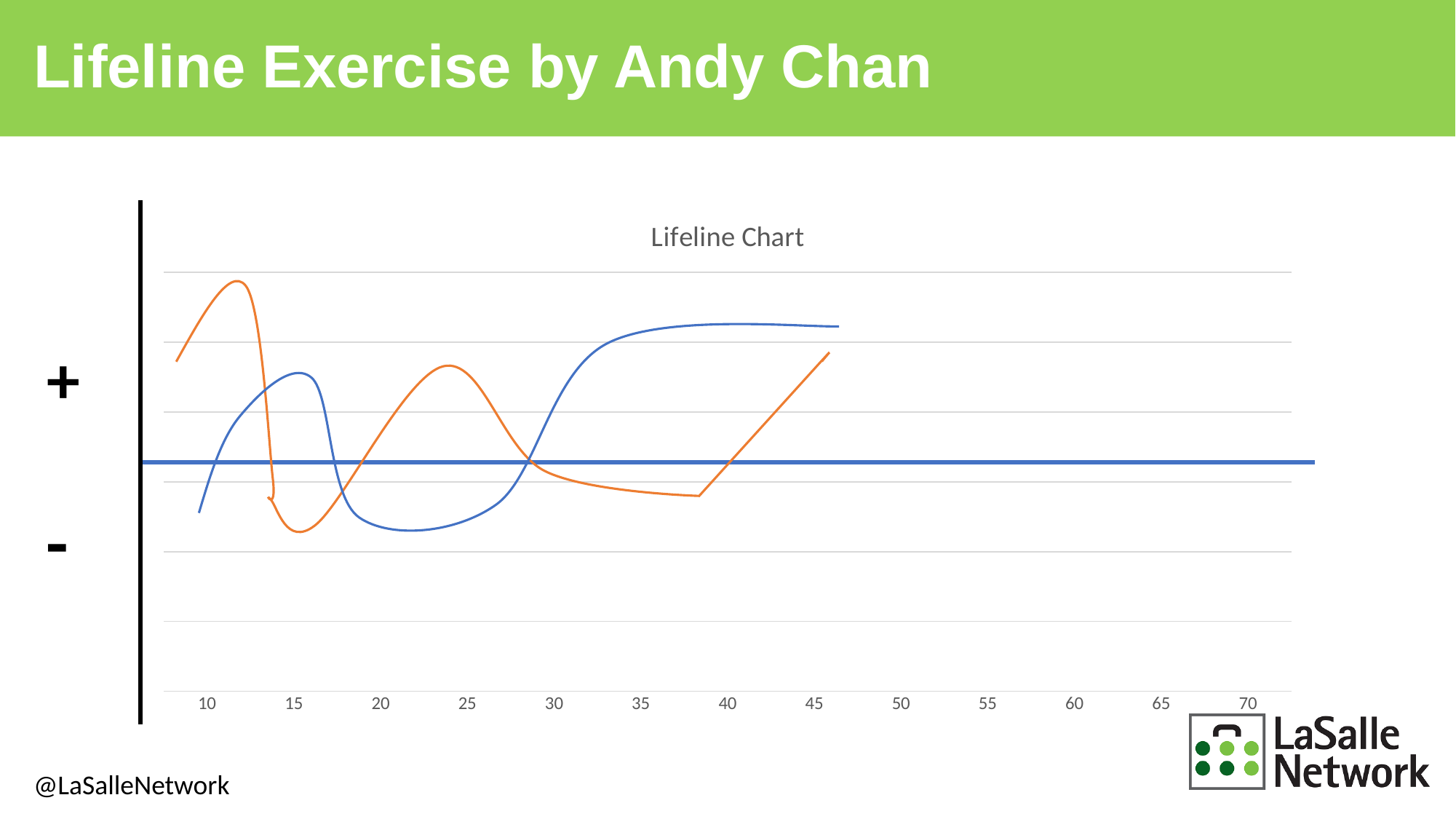
What is the lowest tick label on the x axis of the Lifeline Chart? 10 How many tick labels are shown on the x axis of the Lifeline Chart? 13 Which line reaches the highest point on the Lifeline Chart, the orange line or the blue line? orange line Does the orange line rise or fall between 40 and 45 on the x axis? rise Does the orange line rise or fall between 25 and 30 on the x axis? fall Does the blue line rise or fall between 15 and 20 on the x axis? fall How many lines are plotted on the Lifeline Chart? 2 What kind of chart is the Lifeline Chart? line chart What is the highest tick label on the x axis of the Lifeline Chart? 70 What is the title of the chart on the slide? Lifeline Chart What colours are the two lines on the Lifeline Chart? orange and blue